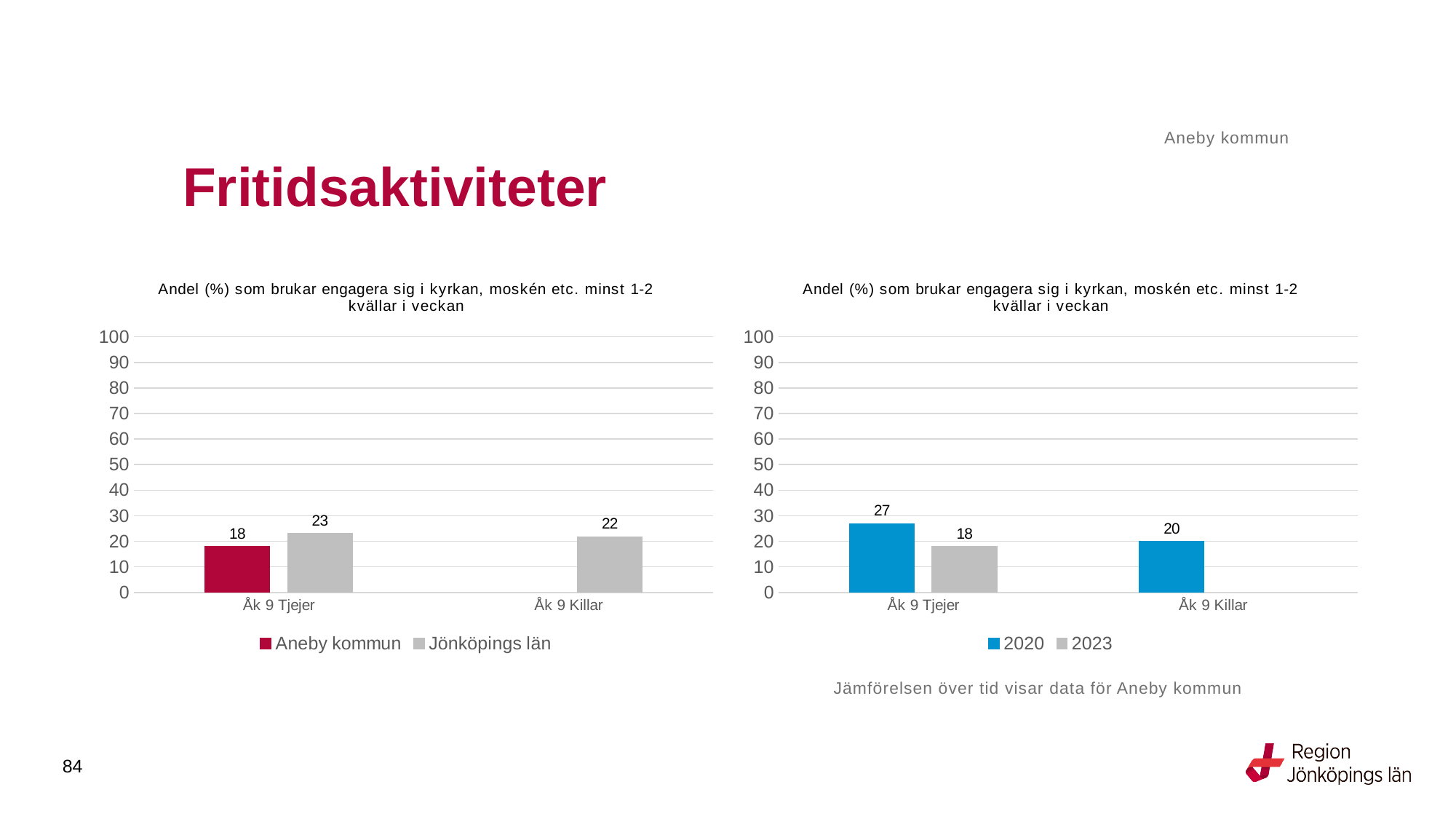
What kind of chart is the right chart? Bar chart In the left chart, what is the value for Jönköpings län for Åk 9 Killar? 22 In the left chart, what is the value for Aneby kommun for Åk 9 Tjejer? 18 In the right chart, what is the value for 2020 for Åk 9 Tjejer? 27 In the right chart, which category has the highest value for 2020? Åk 9 Tjejer In the left chart, which is larger for Åk 9 Tjejer: Aneby kommun or Jönköpings län? Jönköpings län In the right chart, is the value for 2020 for Åk 9 Tjejer greater or less than 30? less In the left chart, what is the difference between Jönköpings län and Aneby kommun for Åk 9 Tjejer? 5 In the right chart, what is the value for 2020 for Åk 9 Killar? 20 In the right chart, what is the difference between the 2020 and 2023 values for Åk 9 Tjejer? 9 In the right chart, what is the value for 2023 for Åk 9 Tjejer? 18 In the left chart, how many series does the legend list? 2